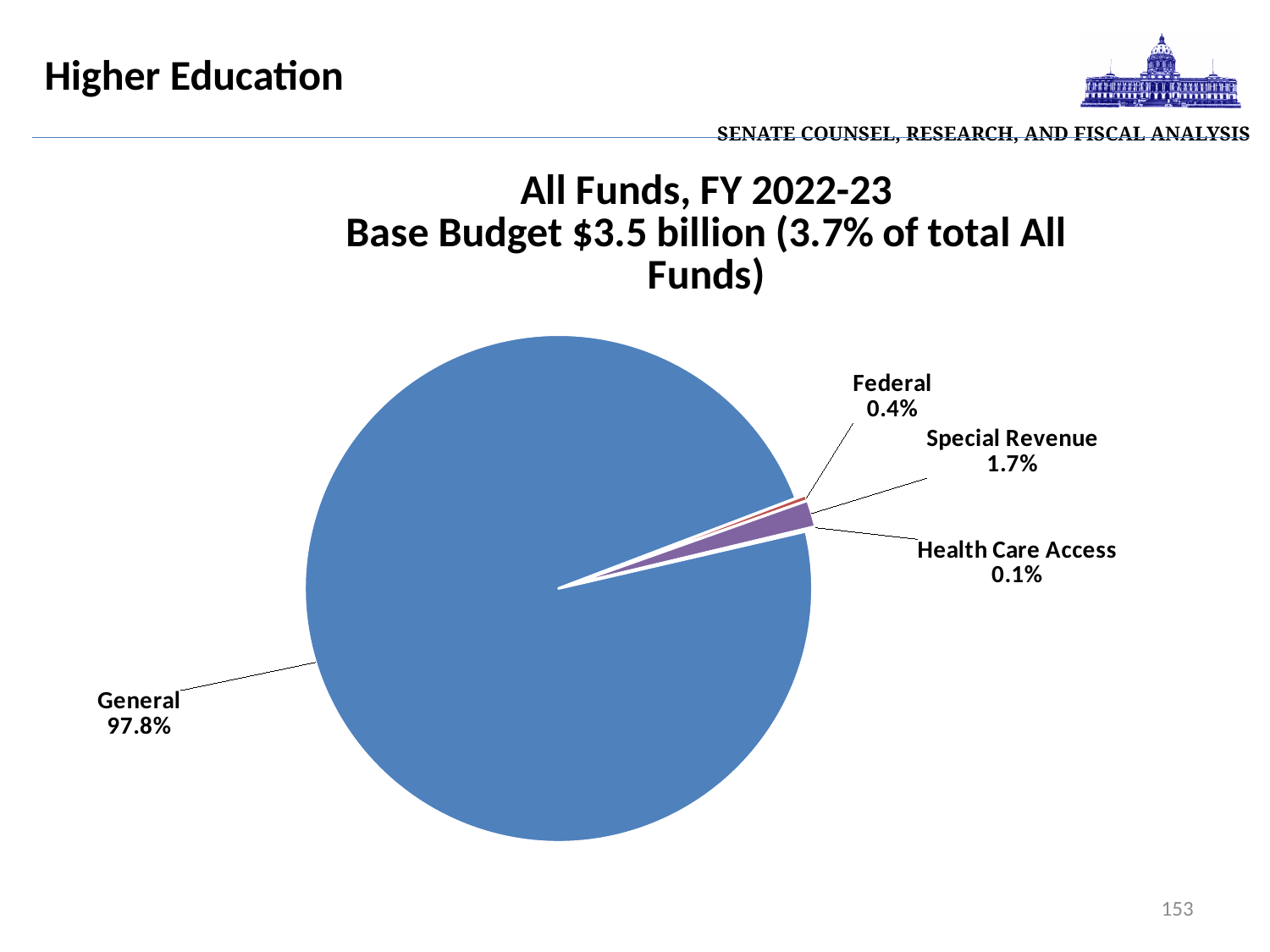
What is the difference between the Special Revenue share and the Federal share? 1.3% What is the title of the chart? All Funds, FY 2022-23 Base Budget $3.5 billion (3.7% of total All Funds) Which is larger, Special Revenue or Federal? Special Revenue What share of the pie does the General fund account for? 97.8% What is the value shown for Special Revenue? 1.7% Which slice of the pie is the largest? General Which slice of the pie is the smallest? Health Care Access What kind of chart is shown on the slide? pie chart How many slices does the pie chart have? 4 What is the value shown for Health Care Access? 0.1% What is the difference between the Federal share and the Health Care Access share? 0.3% What is the value shown for Federal? 0.4%